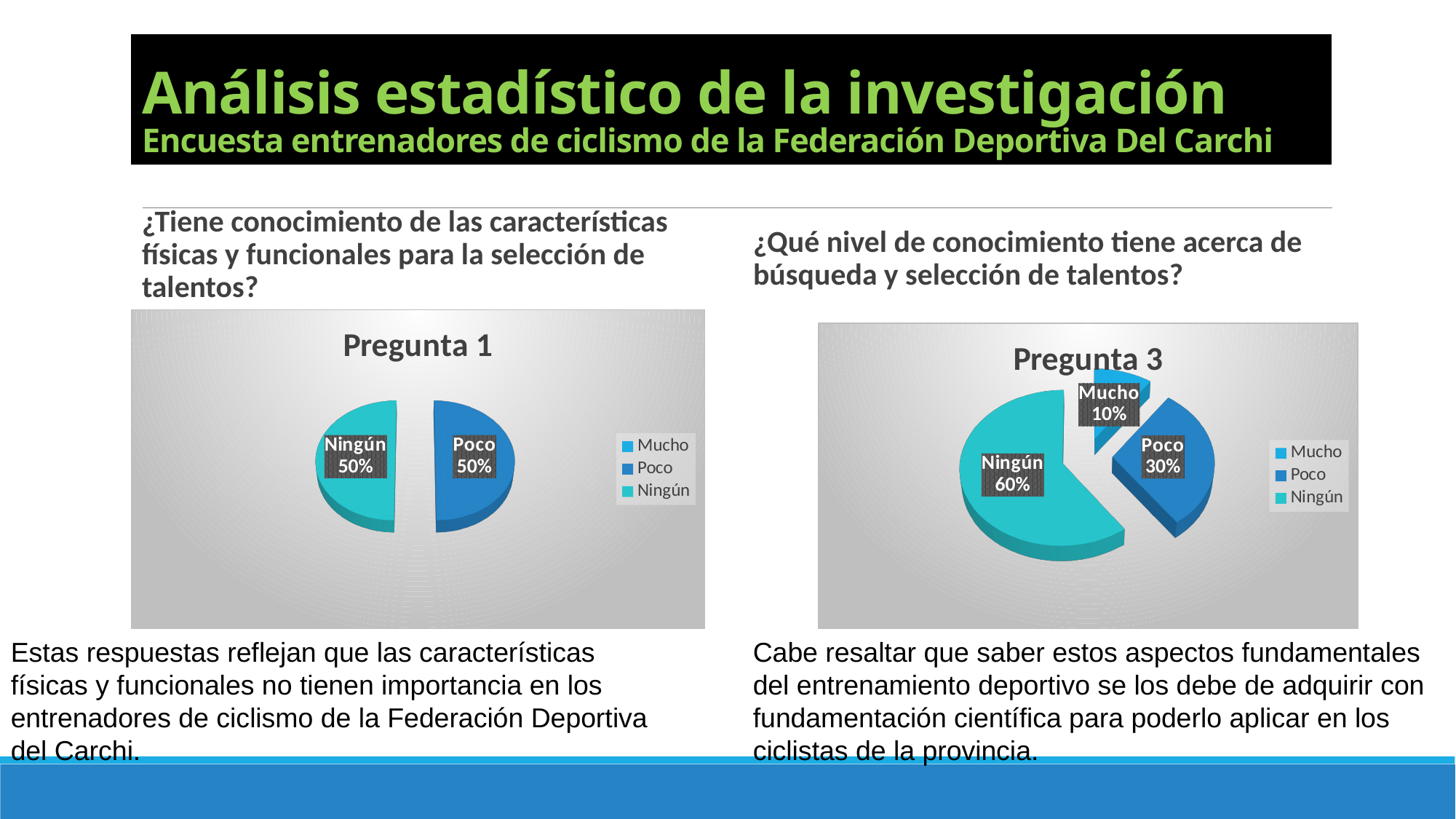
In the 'Pregunta 3' chart, which is larger, Poco or Mucho? Poco What is the title of the chart on the left side of the slide? Pregunta 1 In the 'Pregunta 3' chart, which category has the smallest share? Mucho In the 'Pregunta 3' chart, what is the difference between the Ningún and Poco shares? 30% In the 'Pregunta 3' chart, which category has the largest share? Ningún In the 'Pregunta 1' chart, what share does Poco have? 50% In the 'Pregunta 3' chart, what share does Mucho have? 10% In the 'Pregunta 3' chart, what share does Poco have? 30% In the 'Pregunta 1' chart, what share does Ningún have? 50% In the 'Pregunta 3' chart, what share does Ningún have? 60% How many entries does the legend of the 'Pregunta 3' chart list? 3 What kind of chart is 'Pregunta 1'? Pie chart